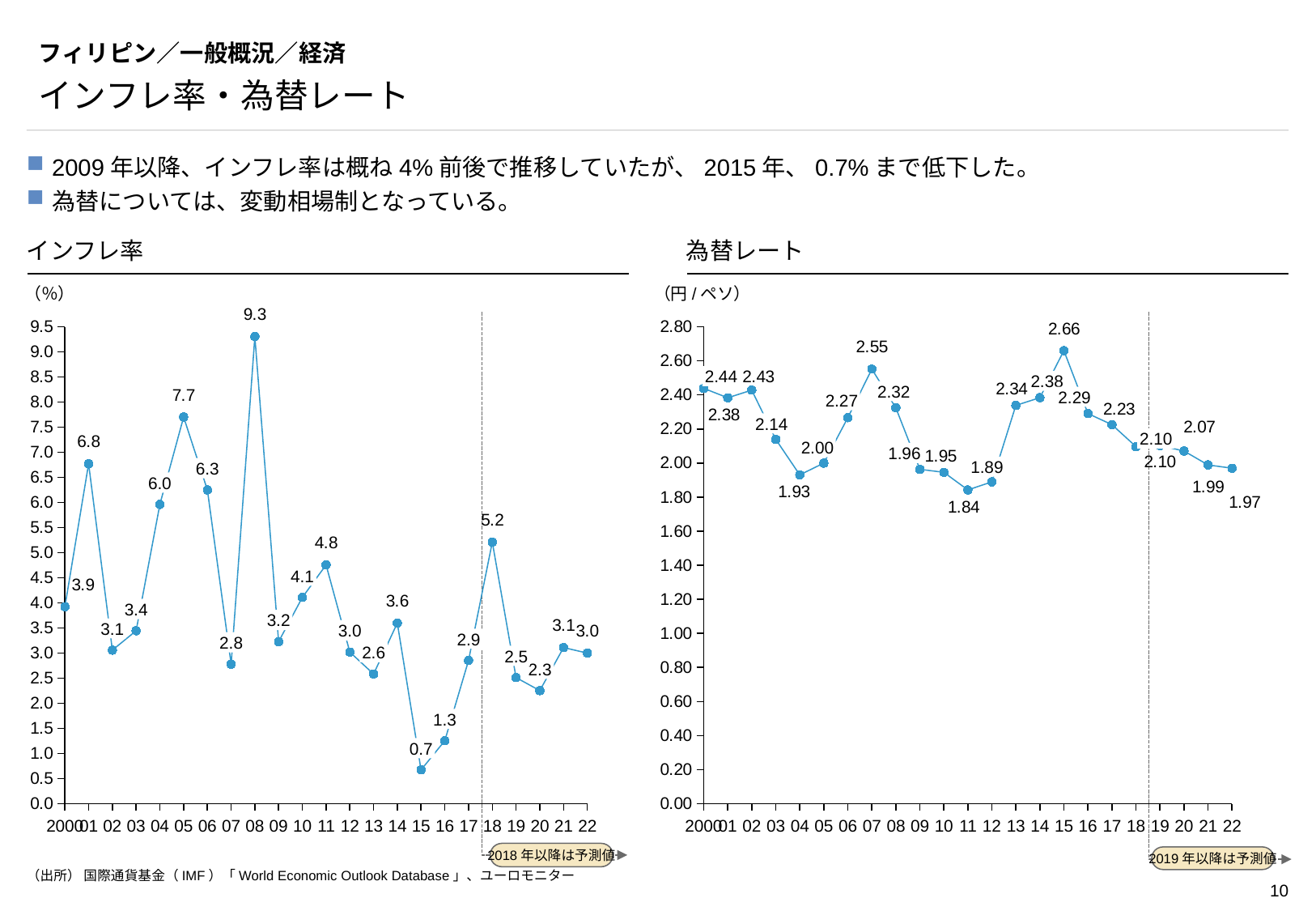
In the インフレ率 chart, which year has the lowest inflation rate? 15 In the 為替レート chart, what is the difference between the values for 2007 and 2009? 0.59 In the インフレ率 chart, what is the value for 2015? 0.7 What kind of chart is the インフレ率 chart? line chart In the インフレ率 chart, what is the difference between the values for 2005 and 2007? 4.9 In the インフレ率 chart, which year has the highest inflation rate? 08 In the インフレ率 chart, which is larger, the value for 2011 or the value for 2018? 2018 In the 為替レート chart, do the values rise or fall from 2015 to 2022? fall In the インフレ率 chart, what is the inflation rate for 2008? 9.3 In the 為替レート chart, which year has the lowest value? 11 In the 為替レート chart, what is the value for 2015? 2.66 In the 為替レート chart, what is the value for 2011? 1.84